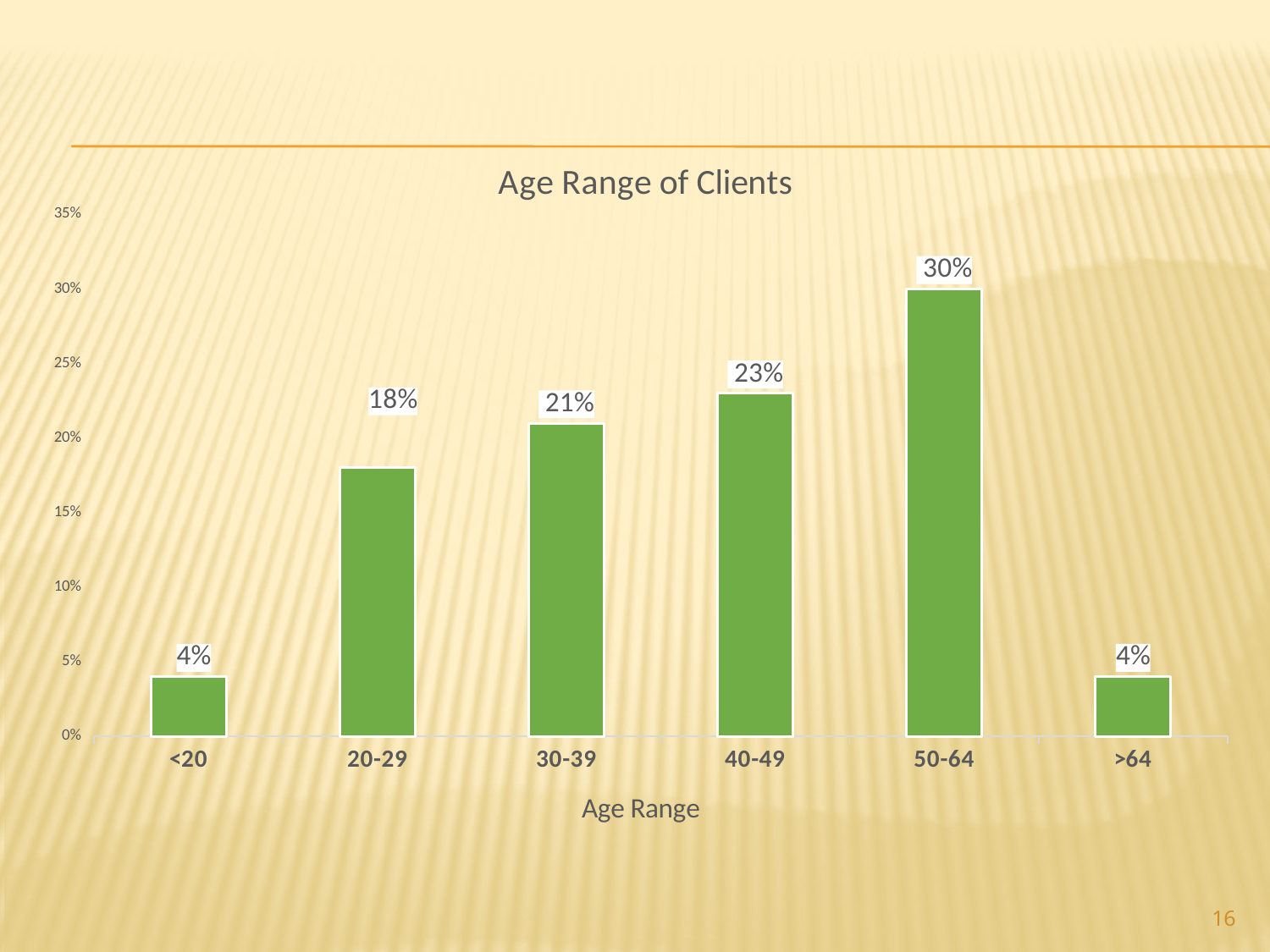
What is the difference between the values for 50-64 and 30-39? 9% What is the label of the x axis? Age Range What is the value for the 40-49 age range? 23% What is the title of the chart? Age Range of Clients What is the value for the 50-64 age range? 30% What is the difference between the values for 40-49 and 20-29? 5% What is the value for the 20-29 age range? 18% Is the value for 20-29 greater or less than 20%? less What kind of chart is shown on the slide? bar chart Which age range has the highest value? 50-64 How many age ranges are shown on the x axis? 6 Which is larger, the value for 30-39 or the value for 40-49? 40-49